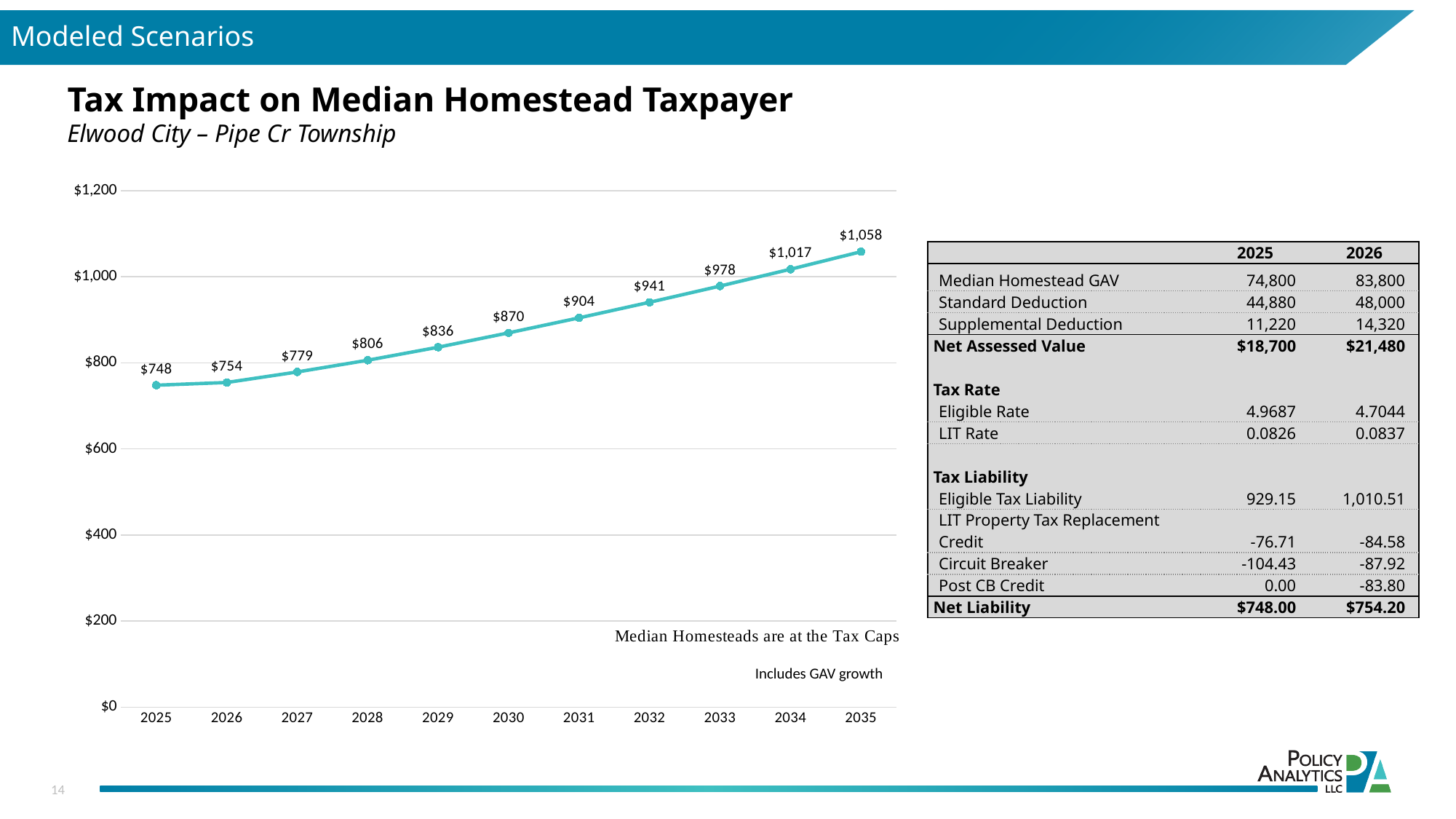
What is the value plotted for 2030? $870 What is the value plotted for 2035? $1,058 Which year has the lowest value on the chart? 2025 Is the value for 2033 greater or less than $1,000? less How many years are plotted on the chart? 11 What is the difference between the values for 2035 and 2025? $310 What is the value plotted for 2025? $748 What kind of chart is shown on the slide? line chart Which year has the highest value on the chart? 2035 What is the difference between the values for 2029 and 2028? $30 Which is larger, the value for 2032 or the value for 2031? 2032 Do the values rise or fall from 2025 to 2035? rise